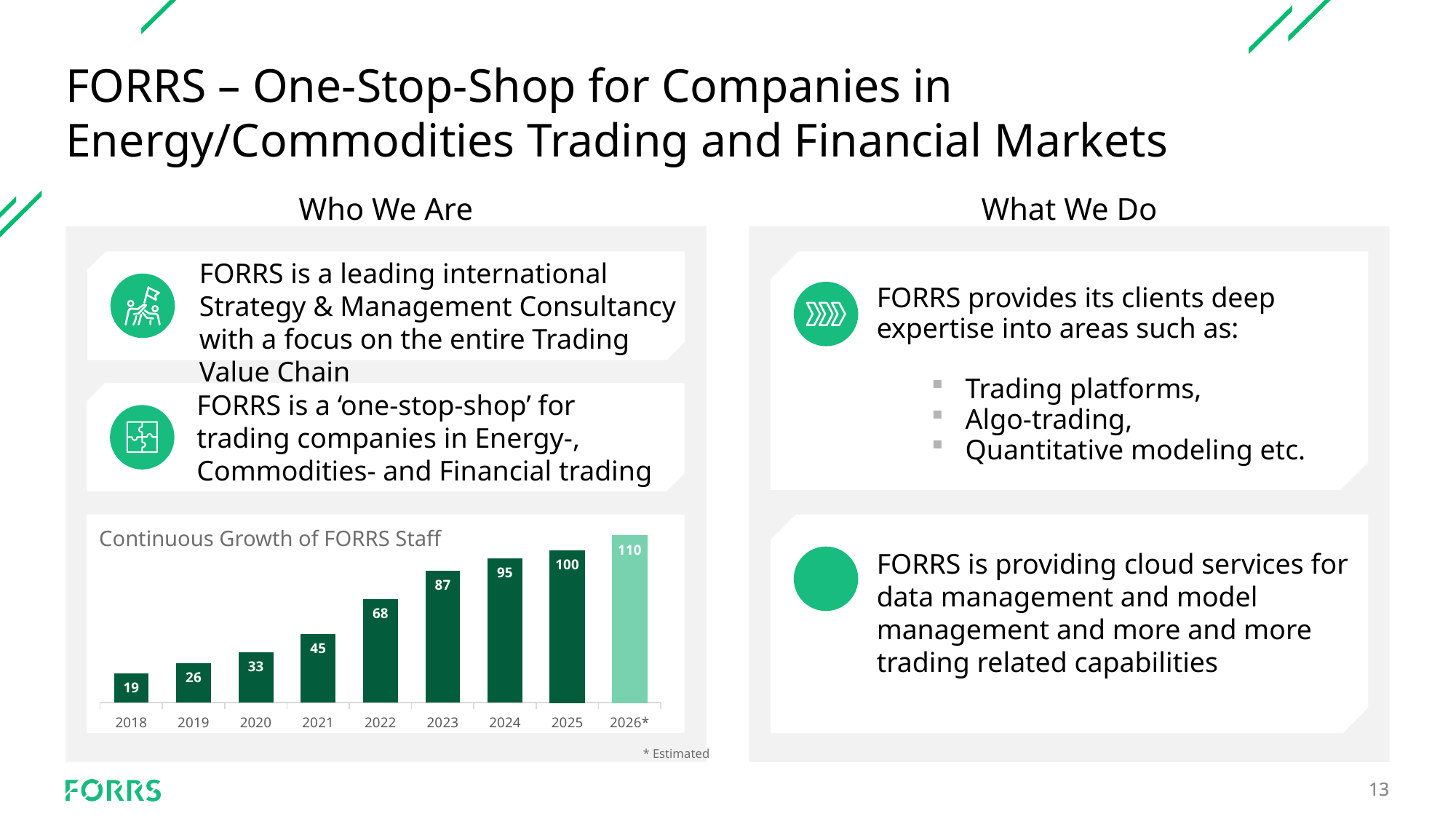
Which year has the highest value in the Continuous Growth of FORRS Staff chart? 2026* What kind of chart is the Continuous Growth of FORRS Staff chart? bar chart How many years are shown on the x axis of the Continuous Growth of FORRS Staff chart? 9 What is the difference between the values for 2025 and 2024 in the Continuous Growth of FORRS Staff chart? 5 Which is larger in the Continuous Growth of FORRS Staff chart, the value for 2020 or the value for 2021? 2021 Do the values in the Continuous Growth of FORRS Staff chart rise or fall from 2018 to 2026*? rise Which year has the lowest value in the Continuous Growth of FORRS Staff chart? 2018 What is the value for 2026* in the Continuous Growth of FORRS Staff chart? 110 What is the difference between the values for 2023 and 2021 in the Continuous Growth of FORRS Staff chart? 42 What is the value for 2018 in the Continuous Growth of FORRS Staff chart? 19 What is the value for 2022 in the Continuous Growth of FORRS Staff chart? 68 What does the asterisk on the 2026* label in the Continuous Growth of FORRS Staff chart indicate? Estimated